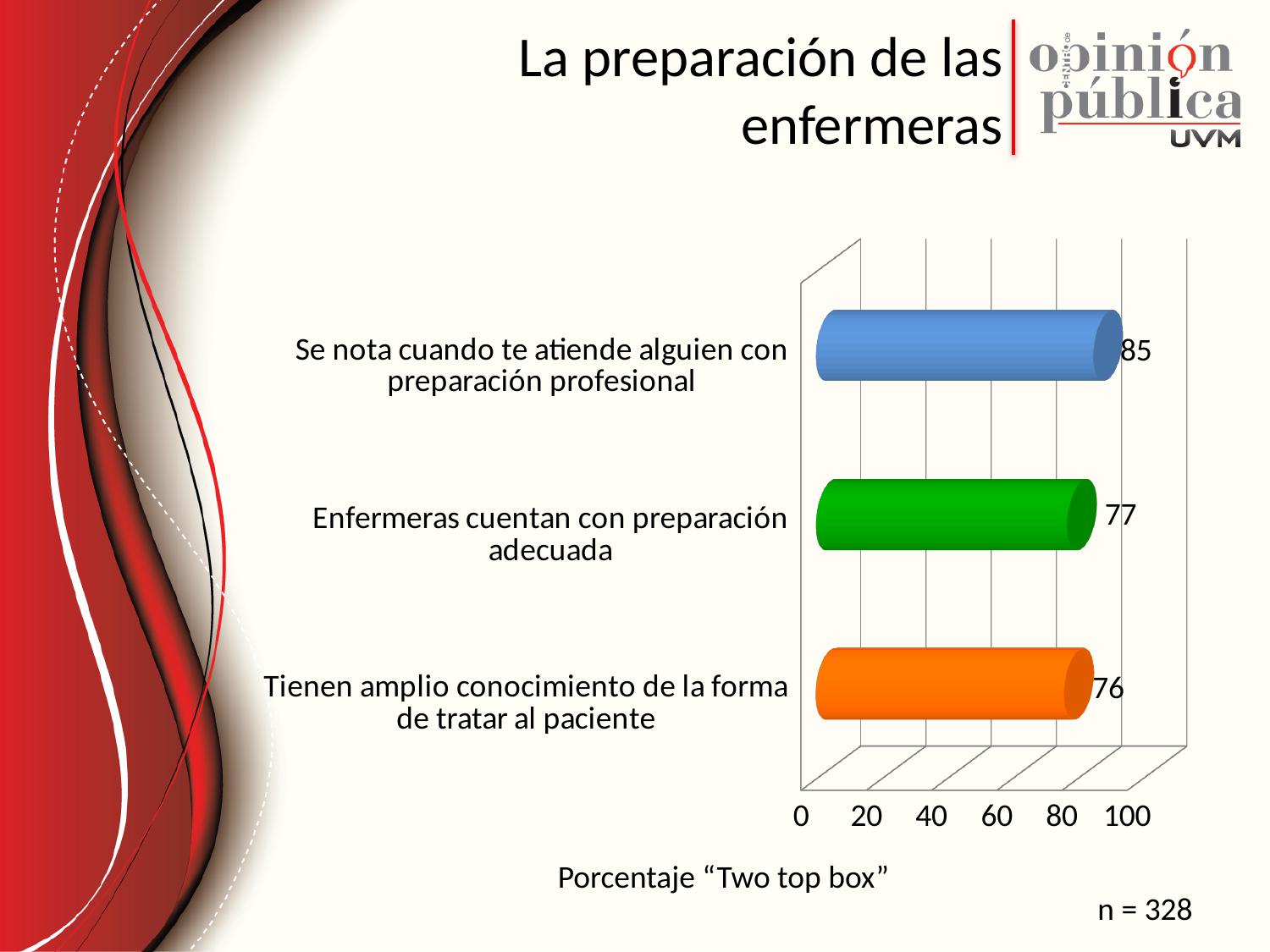
What is the difference between the values for "Se nota cuando te atiende alguien con preparación profesional" and "Enfermeras cuentan con preparación adecuada"? 8 Is the value for "Enfermeras cuentan con preparación adecuada" greater or less than 60? greater Which category has the lowest value? Tienen amplio conocimiento de la forma de tratar al paciente What is the value for "Enfermeras cuentan con preparación adecuada"? 77 How many categories are shown in the chart? 3 Which category has the highest value? Se nota cuando te atiende alguien con preparación profesional What is the value for "Se nota cuando te atiende alguien con preparación profesional"? 85 What kind of chart is shown on the slide? Bar chart Which is larger: the value for "Se nota cuando te atiende alguien con preparación profesional" or for "Enfermeras cuentan con preparación adecuada"? Se nota cuando te atiende alguien con preparación profesional What is the difference between the values for "Se nota cuando te atiende alguien con preparación profesional" and "Tienen amplio conocimiento de la forma de tratar al paciente"? 9 What is the value for "Tienen amplio conocimiento de la forma de tratar al paciente"? 76 What is the title of the slide containing the chart? La preparación de las enfermeras